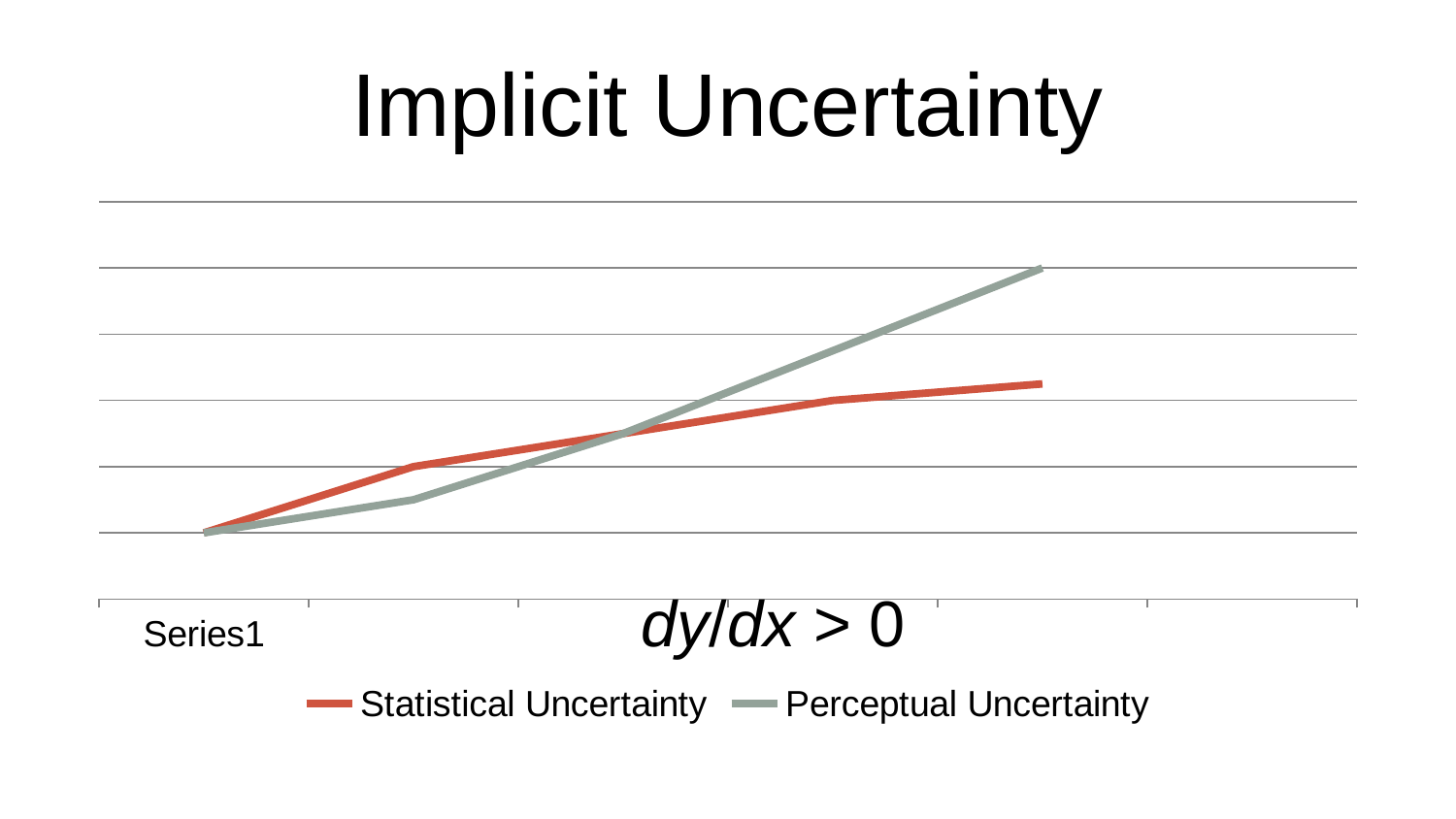
What is the title of the chart on the slide? Implicit Uncertainty Which series reaches the highest value on the chart? Perceptual Uncertainty Does the Statistical Uncertainty line rise or fall from left to right? rise Which series ends at the lower value at the right end of the chart? Statistical Uncertainty At the second point from the left, which series has the higher value, Statistical Uncertainty or Perceptual Uncertainty? Statistical Uncertainty What kind of chart is shown on the slide? line chart Which series is drawn in red? Statistical Uncertainty Does the Perceptual Uncertainty line rise or fall from left to right? rise At the rightmost point, which series has the higher value, Statistical Uncertainty or Perceptual Uncertainty? Perceptual Uncertainty How many series does the legend list? 2